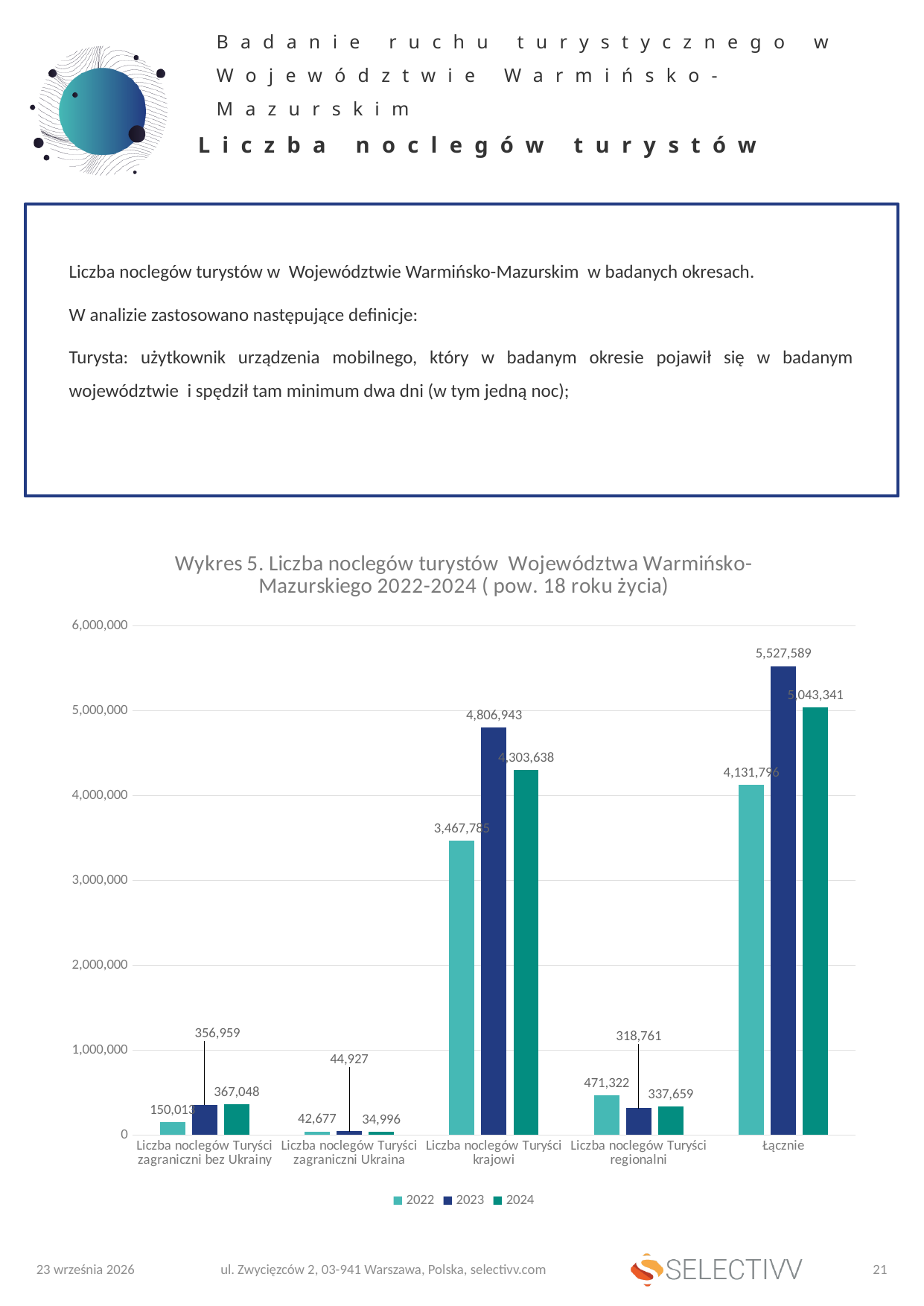
Which is larger in the category 'Liczba noclegów Turyści regionalni': the 2022 value or the 2023 value? 2022 What is the value for 2024 in the category 'Liczba noclegów Turyści zagraniczni Ukraina'? 34,996 What is the difference between the 2023 and 2024 values in the category 'Liczba noclegów Turyści krajowi'? 503,305 How many categories are shown on the x axis? 5 How many series does the legend list? 3 Which category has the lowest values across all three years? Liczba noclegów Turyści zagraniczni Ukraina What is the value for 2024 in the category 'Liczba noclegów Turyści zagraniczni bez Ukrainy'? 367,048 What is the value for 2023 in the category 'Liczba noclegów Turyści krajowi'? 4,806,943 Which year has the highest value in the category 'Łącznie'? 2023 What is the value for 2022 in the category 'Liczba noclegów Turyści regionalni'? 471,322 What is the value for 2023 in the category 'Łącznie'? 5,527,589 What type of chart is shown on the slide? bar chart